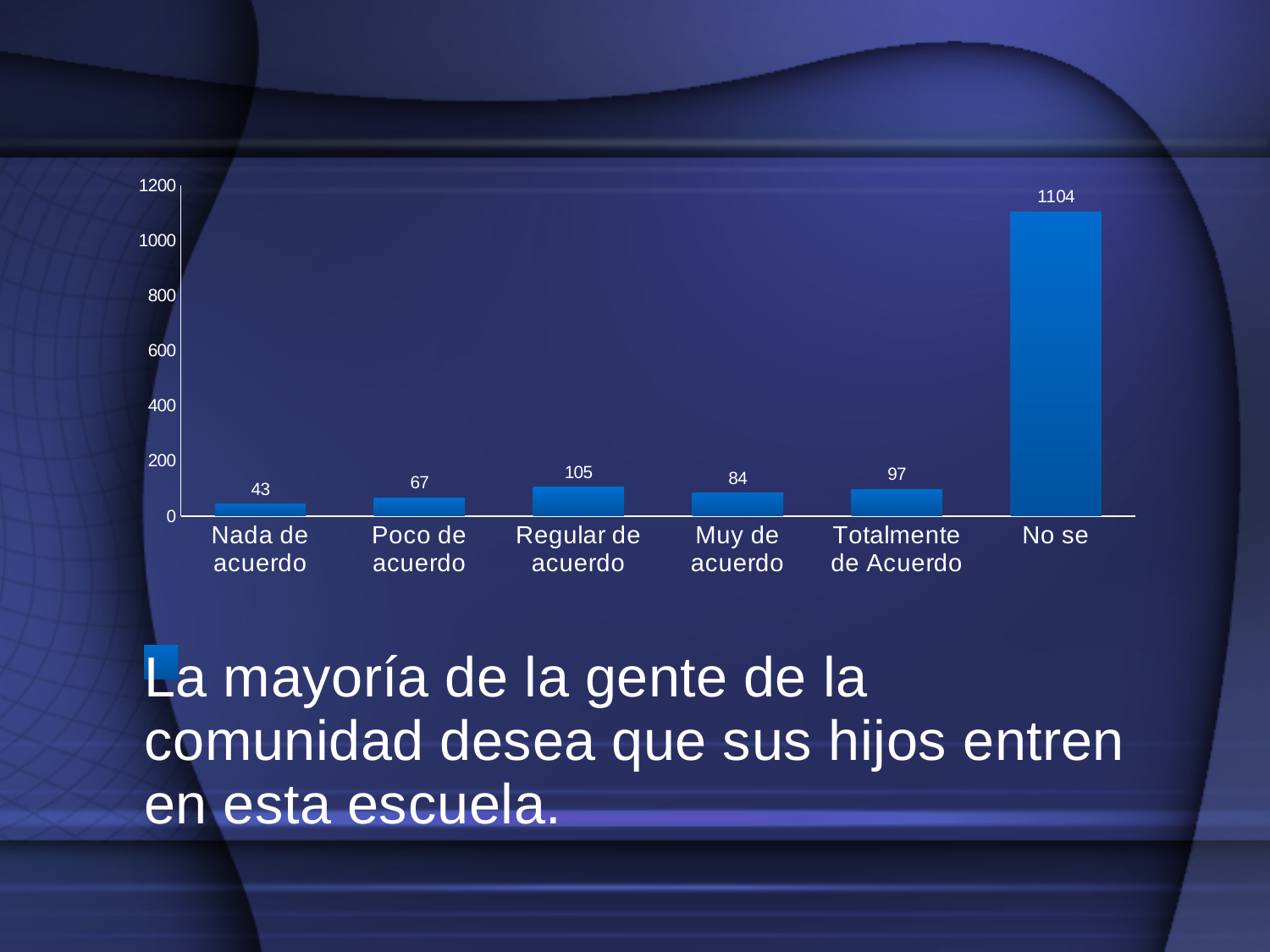
Is the value for "No se" greater or less than 1000? greater What is the value for "Nada de acuerdo"? 43 How many categories are shown on the x axis? 6 What is the value for "Regular de acuerdo"? 105 What is the difference between the values for "Totalmente de Acuerdo" and "Muy de acuerdo"? 13 What is the value for "Totalmente de Acuerdo"? 97 Which is larger, the value for "Poco de acuerdo" or the value for "Muy de acuerdo"? Muy de acuerdo What is the difference between the values for "No se" and "Regular de acuerdo"? 999 What is the value for "No se"? 1104 Which category has the highest value? No se Which category has the lowest value? Nada de acuerdo What kind of chart is shown on the slide? bar chart